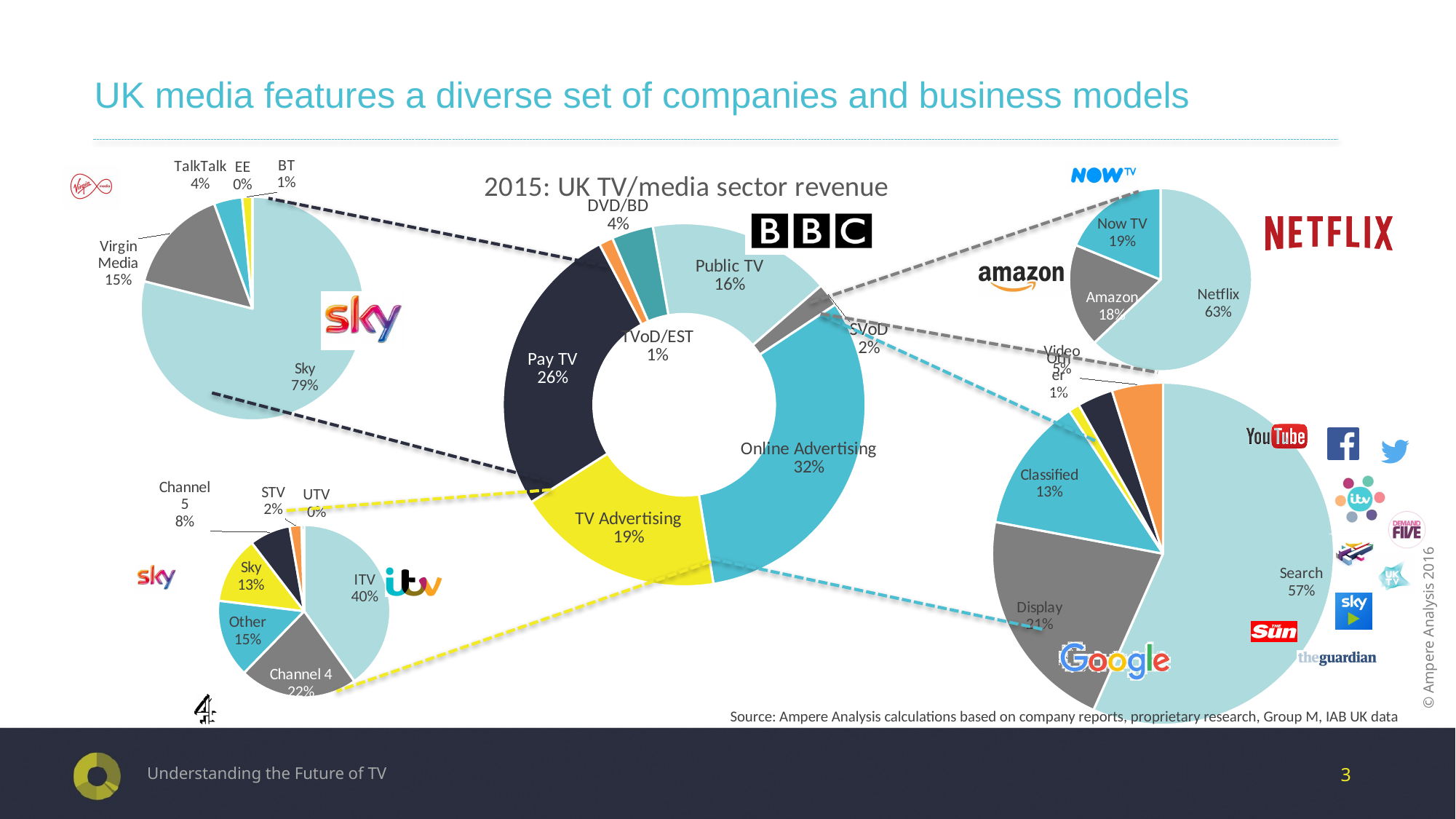
In the top-left pie chart (Pay TV breakdown), what share does Sky hold? 79% In the top-left pie chart (Pay TV breakdown), what share does Virgin Media hold? 15% In the top-right pie chart (SVoD breakdown), which company has the largest share? Netflix In the top-right pie chart (SVoD breakdown), what is the difference between the Now TV share and the Amazon share? 1% In the central donut chart titled '2015: UK TV/media sector revenue', what share is Online Advertising? 32% In the bottom-right pie chart (Online Advertising breakdown), what share does Search hold? 57% In the central donut chart titled '2015: UK TV/media sector revenue', which segment is the largest? Online Advertising In the central donut chart titled '2015: UK TV/media sector revenue', which is larger, Public TV or DVD/BD? Public TV In the bottom-left pie chart (TV Advertising breakdown), what share does ITV hold? 40% In the central donut chart titled '2015: UK TV/media sector revenue', what is the difference between the Pay TV share and the TV Advertising share? 7% In the central donut chart titled '2015: UK TV/media sector revenue', which segment is the smallest? TVoD/EST In the bottom-left pie chart (TV Advertising breakdown), which is larger, Channel 4 or Sky? Channel 4